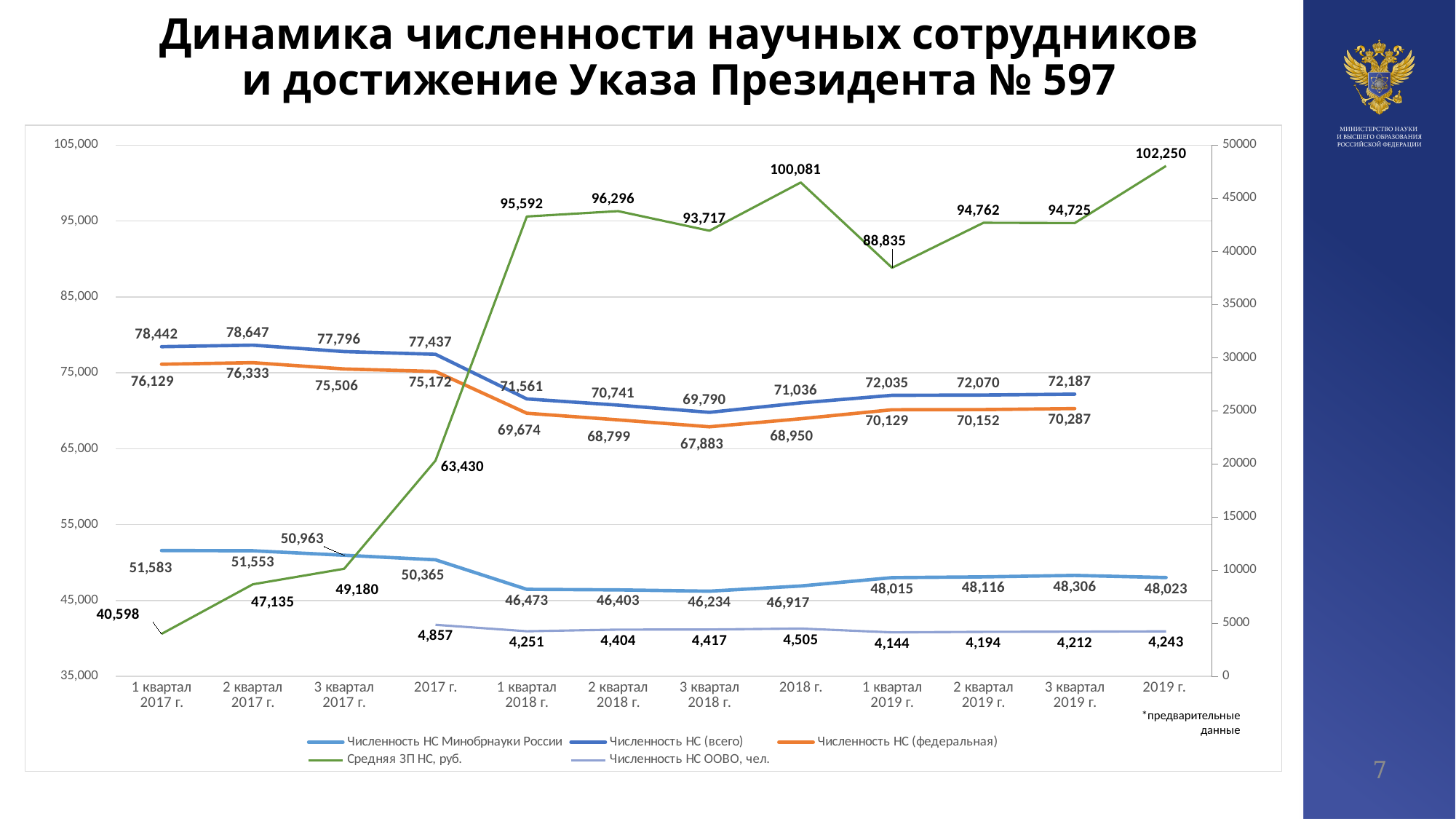
What is the value of Численность НС (всего) for 1 квартал 2018 г.? 71,561 What is the value of Средняя ЗП НС, руб. for 2019 г.? 102,250 How many categories are shown on the x axis? 12 Which is larger for Средняя ЗП НС, руб.: 2018 г. or 1 квартал 2019 г.? 2018 г. What kind of chart is shown on the slide? line chart Does Средняя ЗП НС, руб. rise or fall from 1 квартал 2017 г. to 2017 г.? rise In which period is Средняя ЗП НС, руб. highest? 2019 г. In which period is Средняя ЗП НС, руб. lowest? 1 квартал 2017 г. How many series does the legend list? 5 What colour is the line for Средняя ЗП НС, руб.? green What is the difference between Численность НС (всего) and Численность НС (федеральная) for 3 квартал 2019 г.? 1,900 What is the value of Численность НС ООВО, чел. for 2017 г.? 4,857